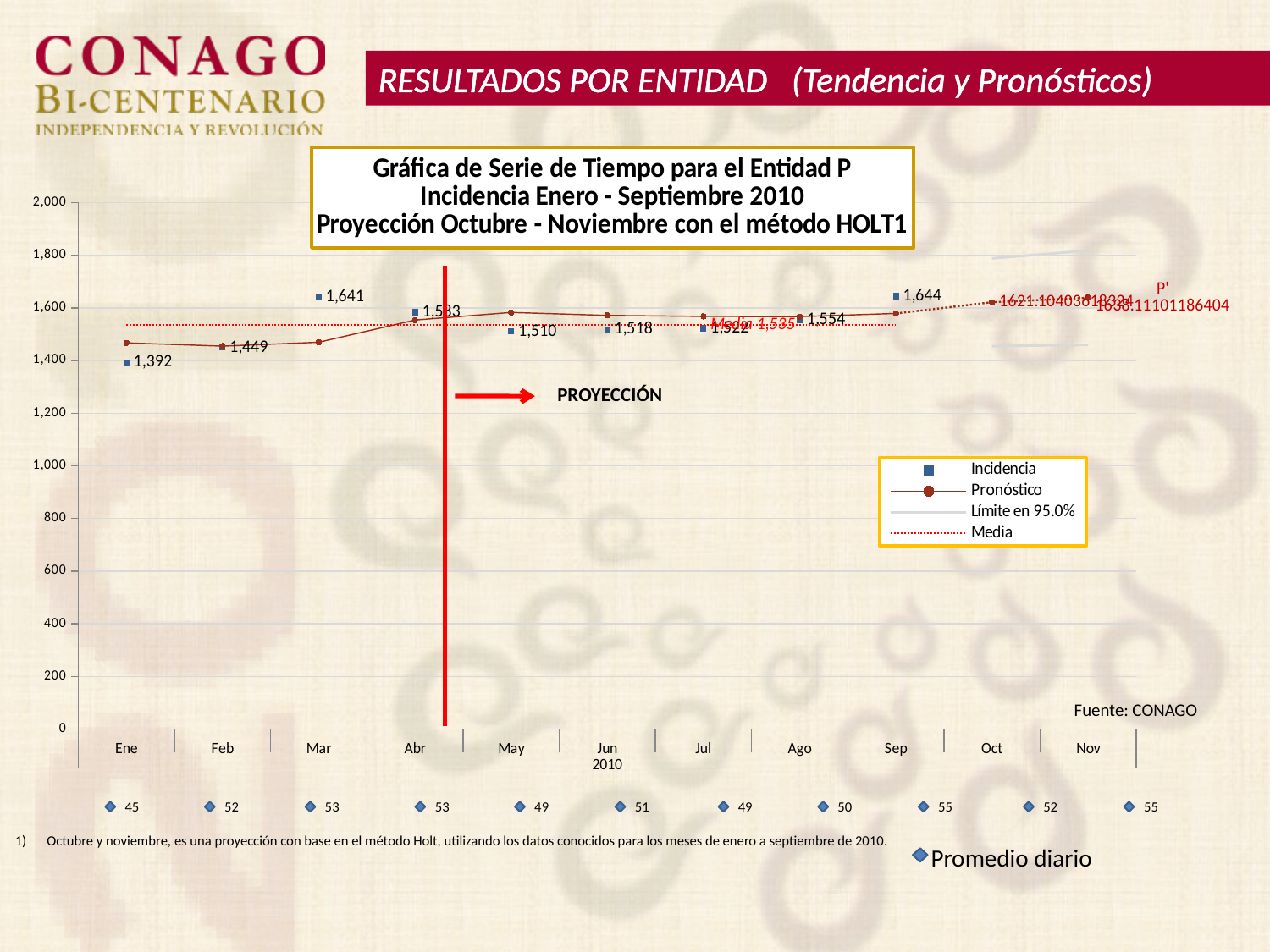
What is the Incidencia value for Sep? 1,644 How many series does the chart legend list? 4 What is the Promedio diario value shown for Sep? 55 What is the Incidencia value for Ene? 1,392 What is the Incidencia value for Ago? 1,554 Which month has the lowest Incidencia value? Ene What is the difference between the Incidencia values for Sep and Ene? 252 What kind of chart is shown on the slide? line chart What is the value of the Media line shown on the chart? 1,535 Which is larger, the Incidencia value for Mar or for May? Mar Is the Incidencia value for Jul greater or less than 1,400? greater How many months are shown on the x axis of the chart? 11